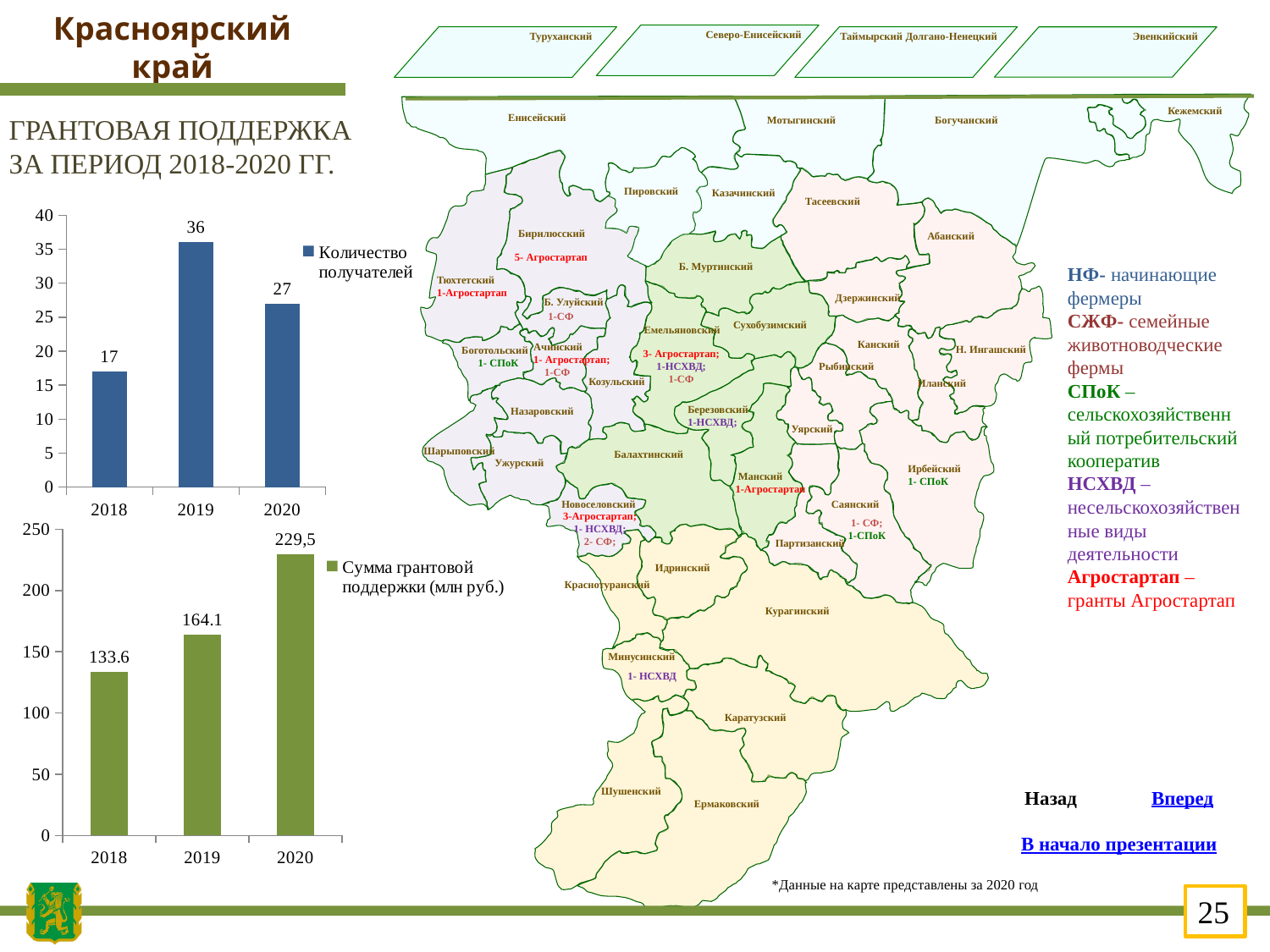
In the bottom chart (Сумма грантовой поддержки), what is the difference between the values for 2019 and 2018? 30.5 How many years (categories) are shown in the top chart (Количество получателей)? 3 In the bottom chart (Сумма грантовой поддержки), do the values rise or fall from 2018 to 2020? rise In the top chart (Количество получателей), which is larger: the value for 2020 or the value for 2018? 2020 In the top chart (Количество получателей), what is the difference between the values for 2019 and 2020? 9 In the bottom chart (Сумма грантовой поддержки), what is the value for 2020? 229,5 In the bottom chart (Сумма грантовой поддержки), what is the value for 2018? 133.6 In the bottom chart (Сумма грантовой поддержки), which year has the lowest value? 2018 What type of chart is the bottom chart (Сумма грантовой поддержки)? bar chart In the top chart (Количество получателей), which year has the highest value? 2019 In the top chart (Количество получателей), what is the value for 2019? 36 In the top chart (Количество получателей), what is the value for 2018? 17